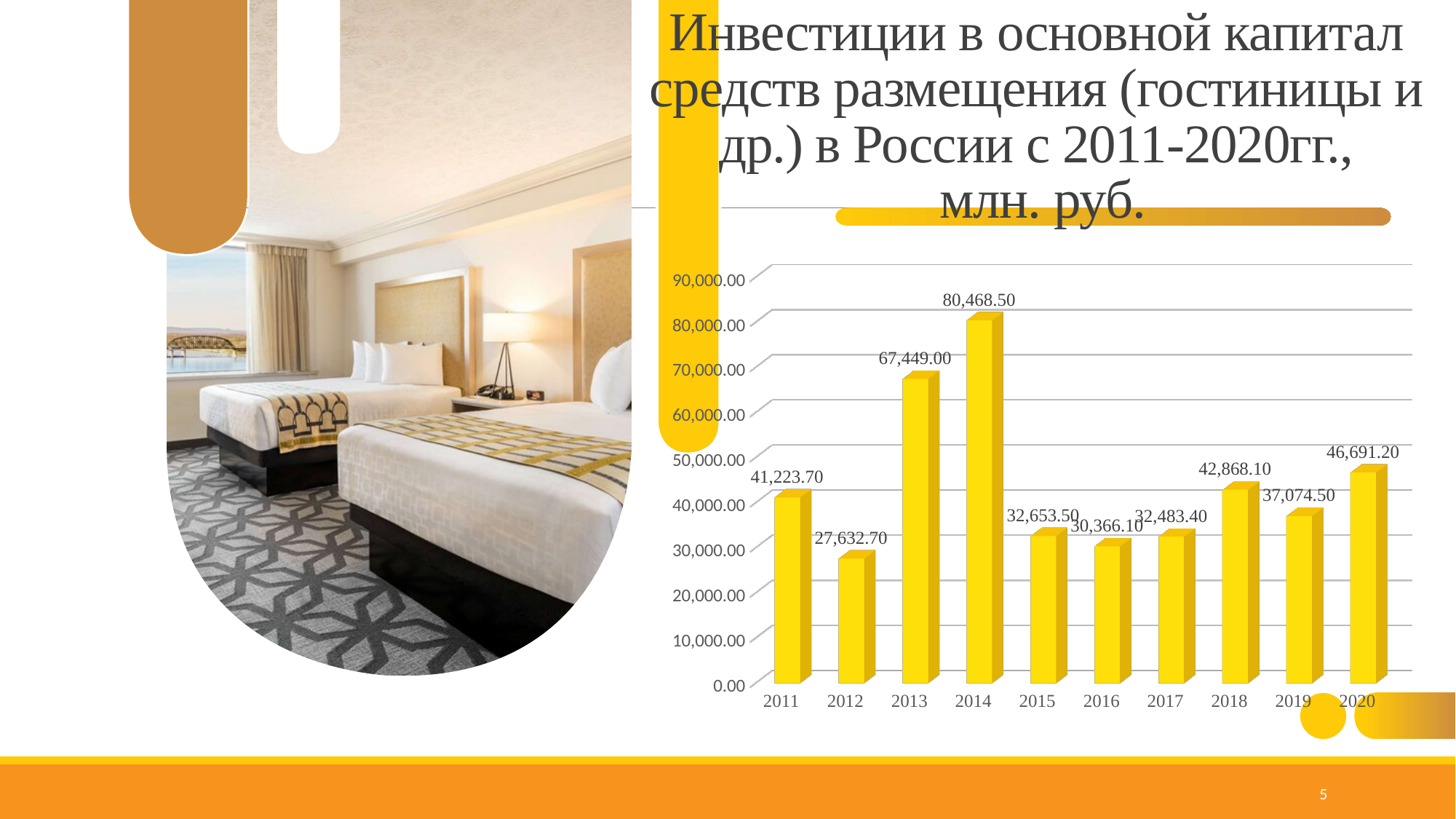
What is the difference between the values for 2014 and 2013? 13,019.50 Is the value for 2016 greater or less than 40,000.00? less Which year has the lowest value? 2012 Which year has the highest value? 2014 Which is larger, the value for 2018 or the value for 2019? 2018 What is the value for 2014? 80,468.50 What is the value for 2012? 27,632.70 What kind of chart is shown on the slide? bar chart What is the value for 2016? 30,366.10 What is the value for 2020? 46,691.20 What is the difference between the values for 2020 and 2019? 9,616.70 How many years are shown on the x axis? 10